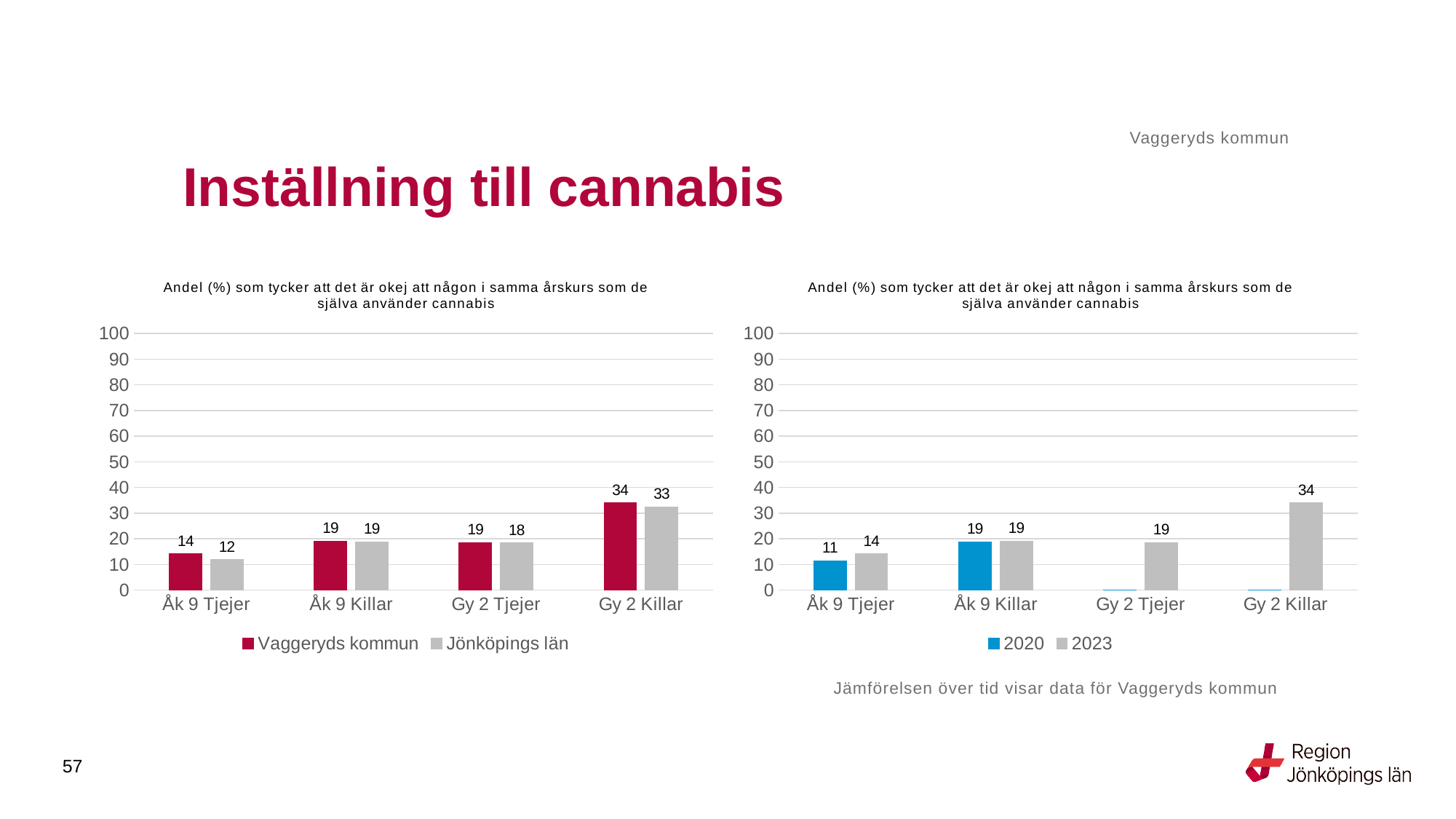
In the right chart, what is the value for 2020 for Åk 9 Tjejer? 11 In the left chart, which category has the lowest value for Jönköpings län? Åk 9 Tjejer What kind of chart is the left chart? Bar chart In the left chart, which category has the highest value for Vaggeryds kommun? Gy 2 Killar In the right chart, what is the value for 2023 for Gy 2 Killar? 34 In the left chart, what is the value for Vaggeryds kommun for Gy 2 Killar? 34 In the right chart, which is larger for Åk 9 Tjejer, 2020 or 2023? 2023 In the left chart, what is the difference between Vaggeryds kommun and Jönköpings län for Åk 9 Tjejer? 2 In the left chart, what is the value for Jönköpings län for Åk 9 Tjejer? 12 In the right chart, how many categories are shown on the x axis? 4 In the right chart, what is the difference between 2023 and 2020 for Åk 9 Tjejer? 3 In the left chart, how many series does the legend list? 2